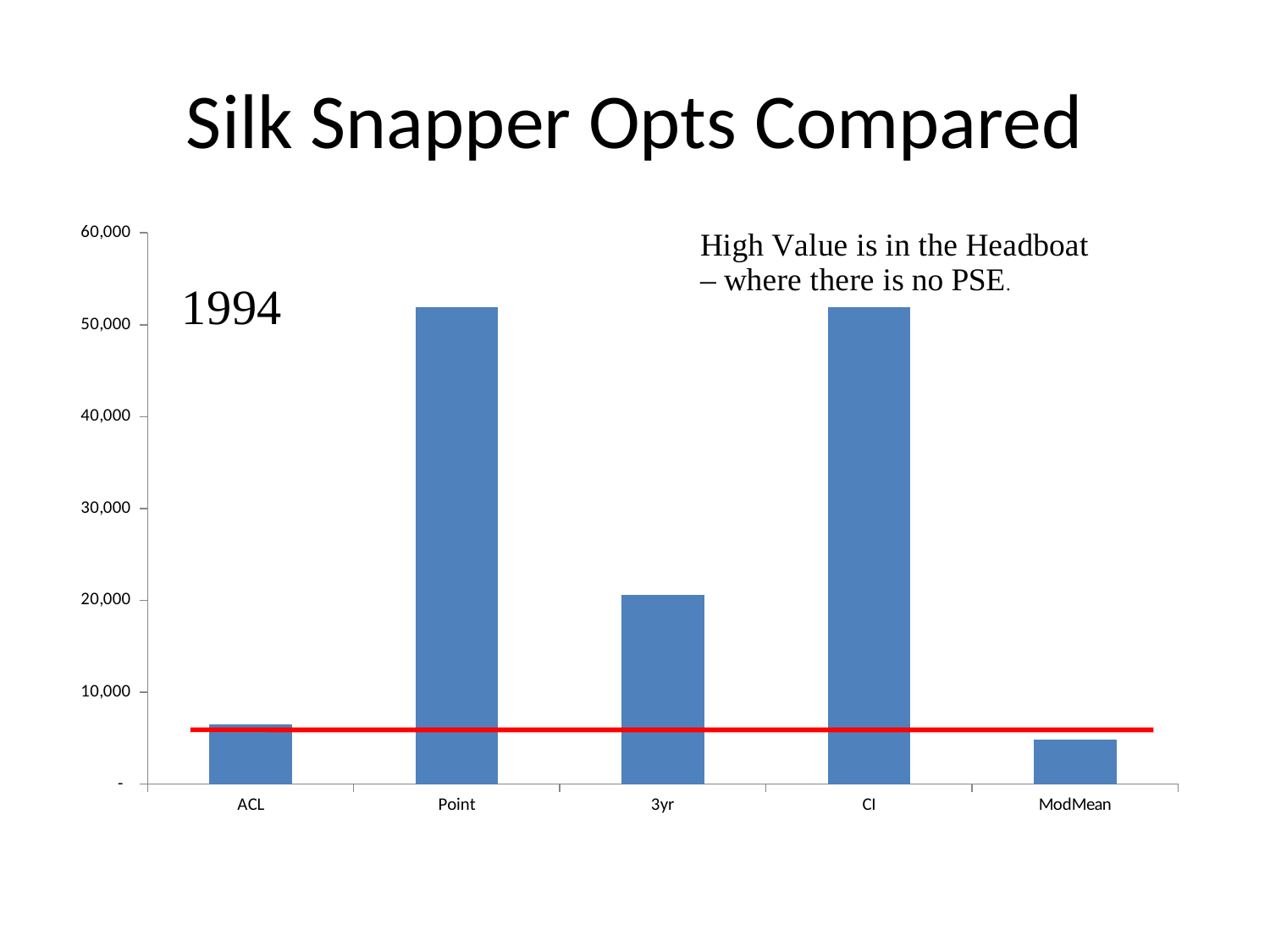
Is the value for ACL greater or less than 10,000? less How many categories are shown on the x axis of the chart? 5 Is the value for 3yr greater or less than 30,000? less What is the title of the slide containing the chart? Silk Snapper Opts Compared Which category has the lowest bar in the chart? ModMean What kind of chart is shown on the slide? bar chart Which is larger, the value for ACL or the value for ModMean? ACL What year is labelled on the chart? 1994 Is the value for ModMean greater or less than 10,000? less Which is larger, the value for Point or the value for 3yr? Point